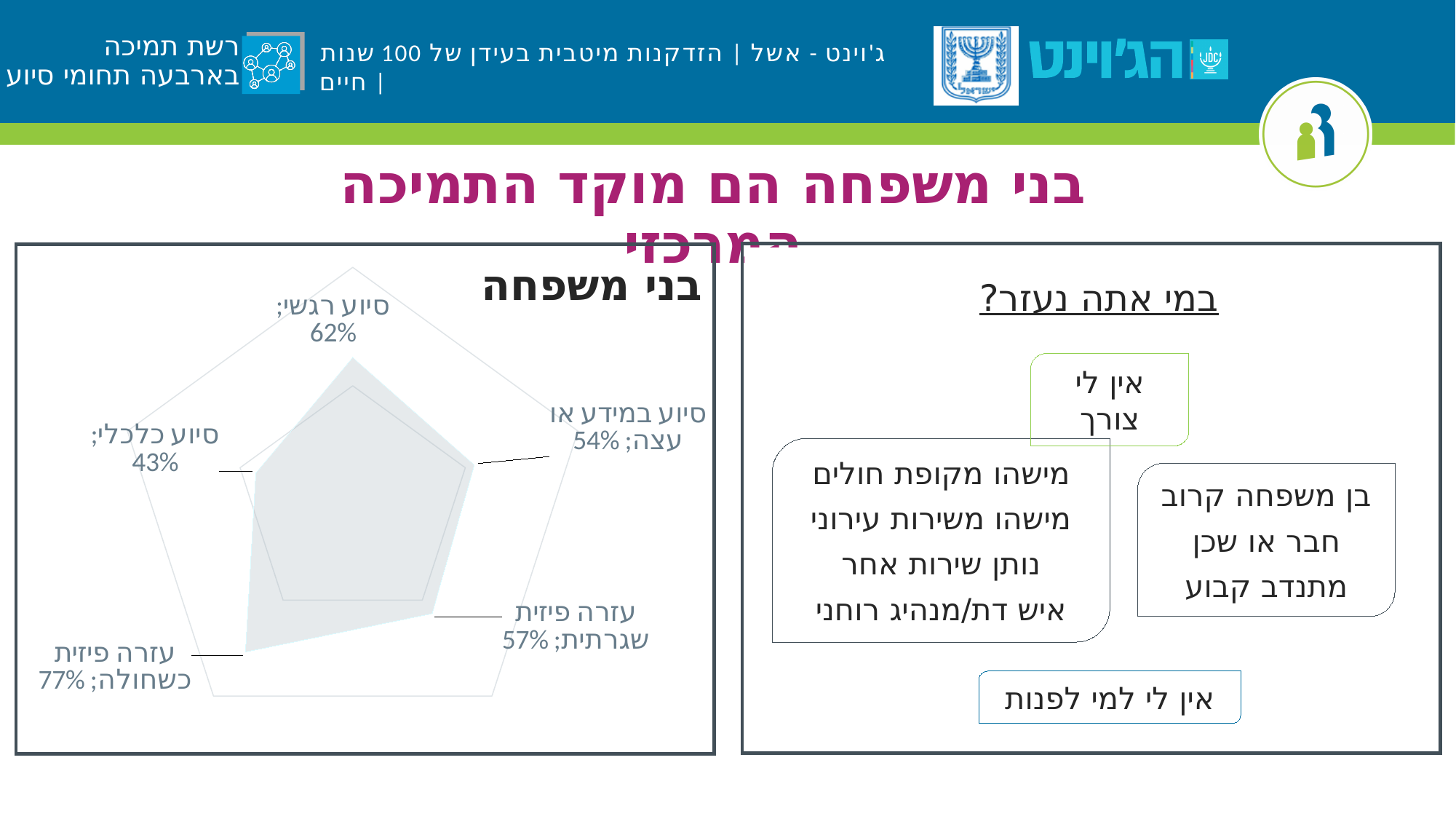
What type of chart is shown on the slide? radar chart What is the title of the chart? בני משפחה Which is larger, סיוע רגשי or סיוע במידע או עצה? סיוע רגשי What is the value for סיוע כלכלי? 43% How many categories does the radar chart have? 5 What is the difference between עזרה פיזית כשחולה and סיוע כלכלי? 34% Which category has the lowest value? סיוע כלכלי What is the value for עזרה פיזית שגרתית? 57% What is the value for סיוע רגשי? 62% What is the value for סיוע במידע או עצה? 54% What is the value for עזרה פיזית כשחולה? 77% Which category has the highest value? עזרה פיזית כשחולה